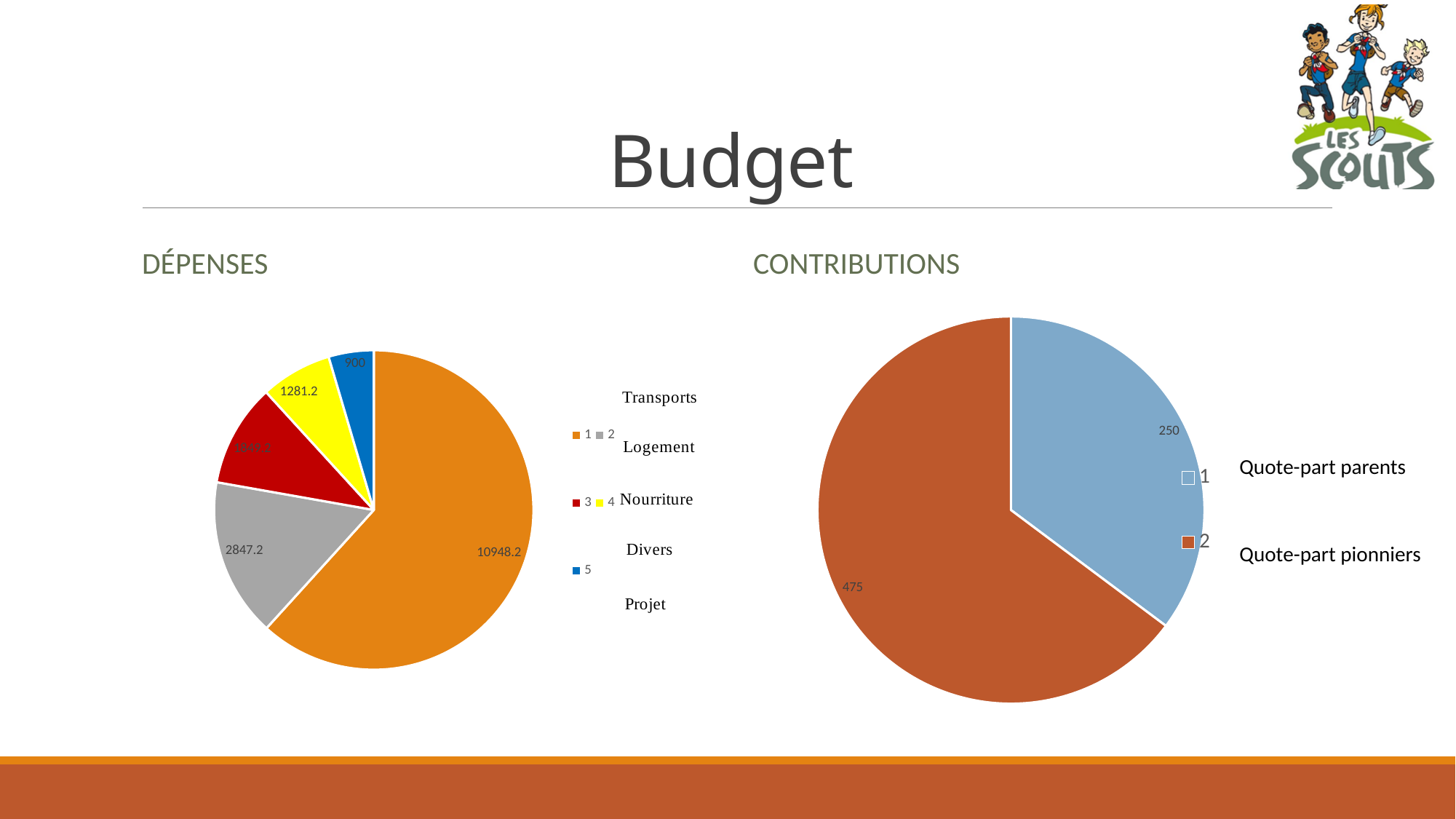
In the DÉPENSES chart, what is the difference between the grey slice (2847.2) and the yellow slice (1281.2)? 1566 How many slices does the DÉPENSES pie chart have? 5 In the DÉPENSES chart, what is the value of the orange slice (legend entry 1)? 10948.2 In the DÉPENSES chart, what is the value of the yellow slice (legend entry 4)? 1281.2 What kind of chart is the DÉPENSES chart? pie chart In the DÉPENSES chart, what is the value of the blue slice (legend entry 5)? 900 In the CONTRIBUTIONS chart, which is larger: Quote-part parents or Quote-part pionniers? Quote-part pionniers In the CONTRIBUTIONS chart, what is the difference between Quote-part pionniers and Quote-part parents? 225 In the DÉPENSES chart, what is the value of the grey slice (legend entry 2)? 2847.2 In the DÉPENSES chart, which legend entry has the smallest slice? 5 In the CONTRIBUTIONS chart, what is the value for Quote-part parents? 250 In the CONTRIBUTIONS chart, what is the value for Quote-part pionniers? 475